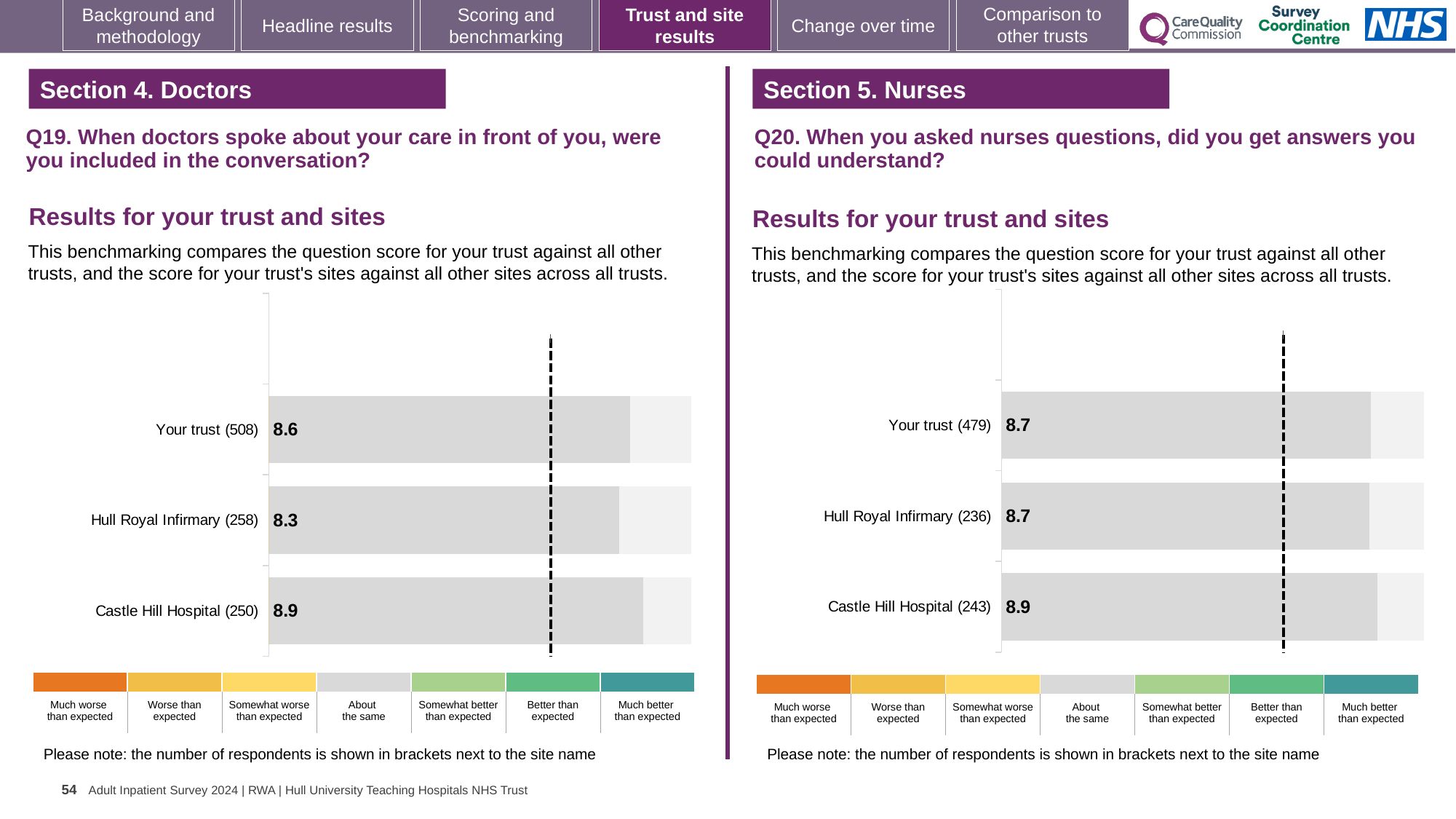
In the Q19 chart on the left, what is the score for Hull Royal Infirmary? 8.3 In the Q20 chart on the right, what is the score for Castle Hill Hospital? 8.9 What type of chart is used for the Q19 results on the left? Bar chart In the Q19 chart on the left, what is the difference between the scores for Castle Hill Hospital and Hull Royal Infirmary? 0.6 In the Q20 chart on the right, what is the difference between the scores for Castle Hill Hospital and Your trust? 0.2 In the Q20 chart on the right, how many bars are plotted? 3 In the Q19 chart on the left, how many respondents are shown in brackets for Your trust? 508 In the Q19 chart on the left, which site or trust has the highest score? Castle Hill Hospital In the Q20 chart on the right, what is the score for Hull Royal Infirmary? 8.7 In the Q19 chart on the left, what is the score for Your trust? 8.6 In the Q20 chart on the right, which site or trust has the highest score? Castle Hill Hospital In the Q19 chart on the left, which site or trust has the lowest score? Hull Royal Infirmary